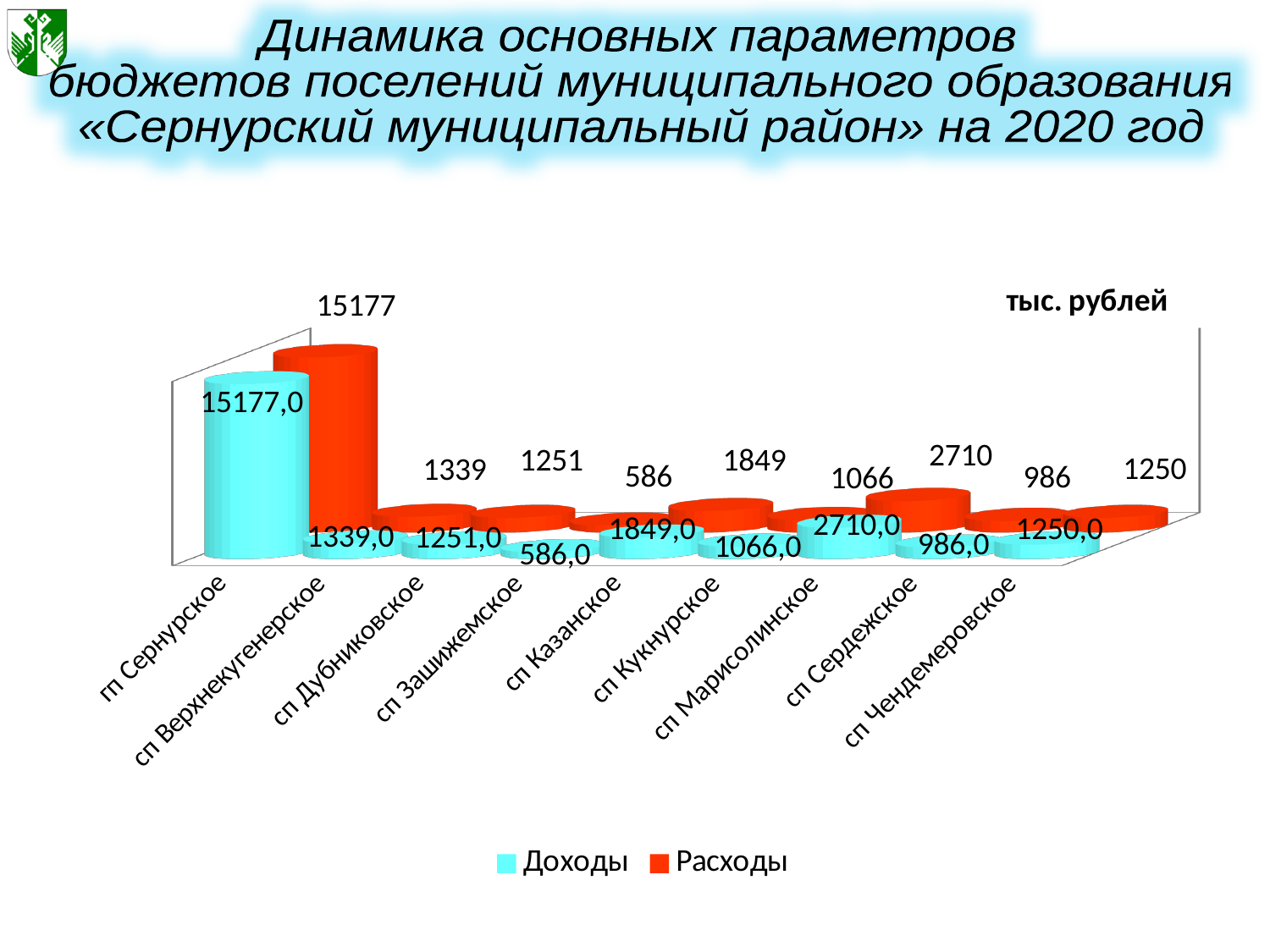
What is the Расходы value for сп Сердежское? 986 Which is larger, the Доходы value for сп Дубниковское or for сп Марисолинское? сп Марисолинское How many settlements (categories) are shown on the x axis? 9 What is the Доходы value for гп Сернурское? 15177,0 Which settlement has the highest Доходы value? гп Сернурское What type of chart is shown on the slide? bar chart What is the Доходы value for сп Зашижемское? 586,0 What unit is indicated in the top right corner of the chart? тыс. рублей How many series does the legend list? 2 What is the difference between the Расходы values for сп Сердежское and сп Кукнурское? 80 What is the Расходы value for сп Кукнурское? 1066 Which settlement has the lowest Расходы value? сп Зашижемское